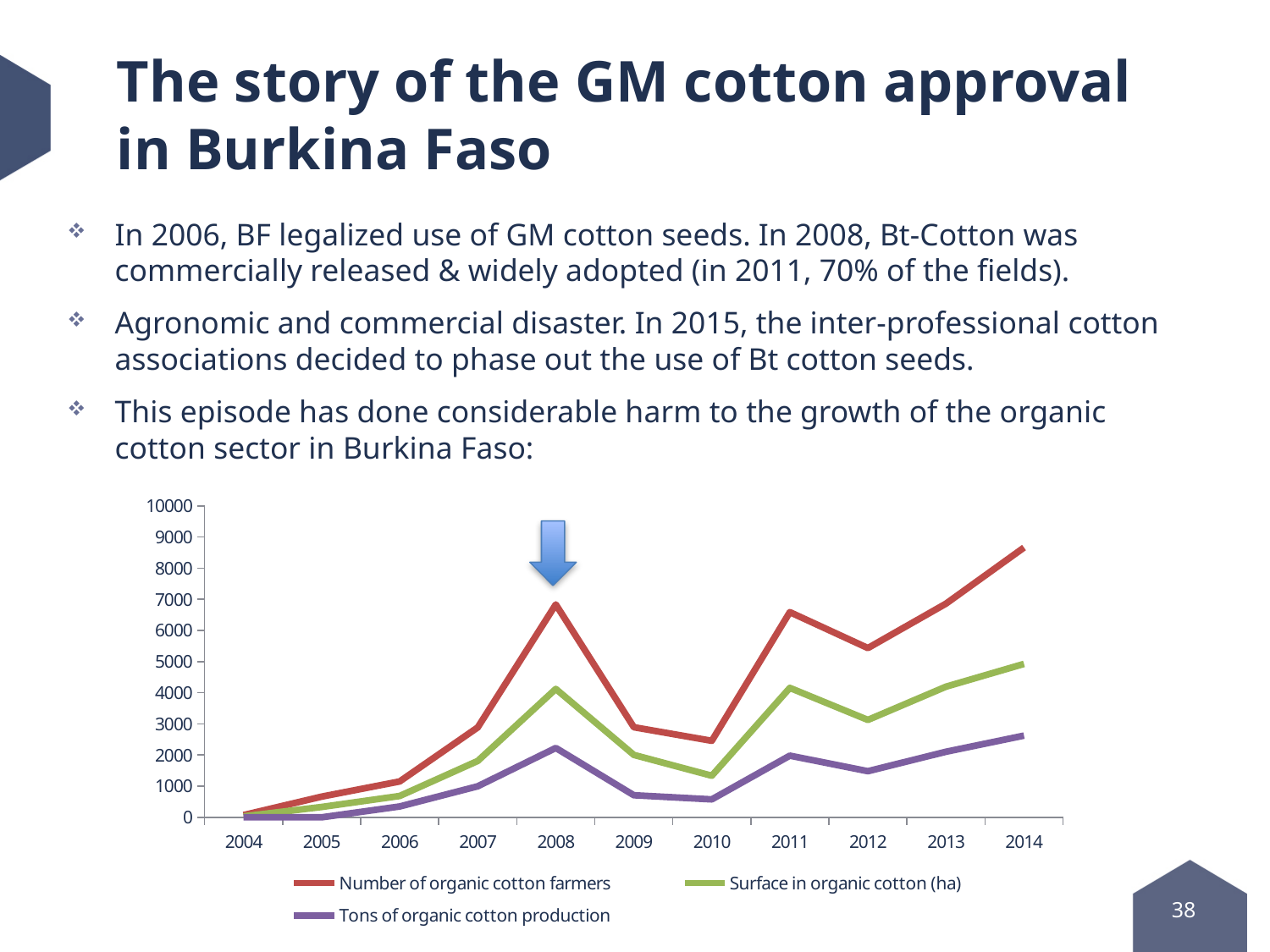
Does the Surface in organic cotton (ha) rise or fall from 2011 to 2012? fall What kind of chart is shown on the slide? line chart In 2011, which is larger: the Number of organic cotton farmers or the Surface in organic cotton (ha)? Number of organic cotton farmers How many years are plotted along the x axis of the chart? 11 Is the Number of organic cotton farmers in 2008 greater or less than 6000? greater How many series does the chart's legend list? 3 What colour is the line for Tons of organic cotton production? purple In which year is the Number of organic cotton farmers highest? 2014 Is the Surface in organic cotton (ha) in 2008 greater or less than 3000? greater Is the Surface in organic cotton (ha) in 2014 greater or less than 4000? greater Does the Number of organic cotton farmers rise or fall from 2008 to 2010? fall